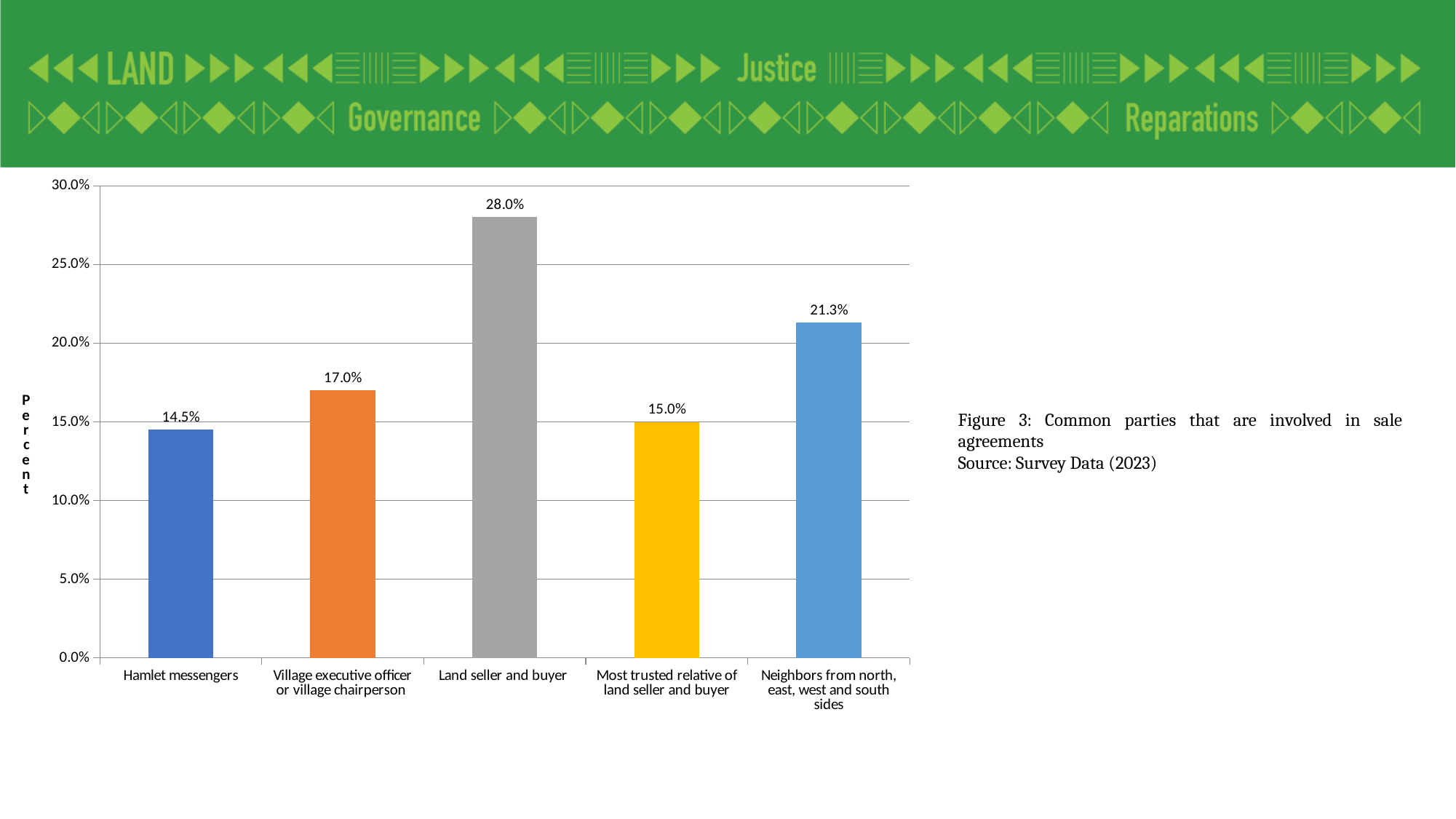
Which category has the highest value? Land seller and buyer What is the value for Land seller and buyer? 28.0% Is the value for Neighbors from north, east, west and south sides greater or less than 20.0%? greater What is the value for Neighbors from north, east, west and south sides? 21.3% What is the label of the vertical axis? Percent How many categories are shown in the chart? 5 What kind of chart is shown on the slide? Bar chart What is the value for Hamlet messengers? 14.5% What is the difference between the values for Land seller and buyer and Neighbors from north, east, west and south sides? 6.7% Which is larger: the value for Village executive officer or village chairperson or the value for Most trusted relative of land seller and buyer? Village executive officer or village chairperson Which category has the lowest value? Hamlet messengers What is the value for Village executive officer or village chairperson? 17.0%